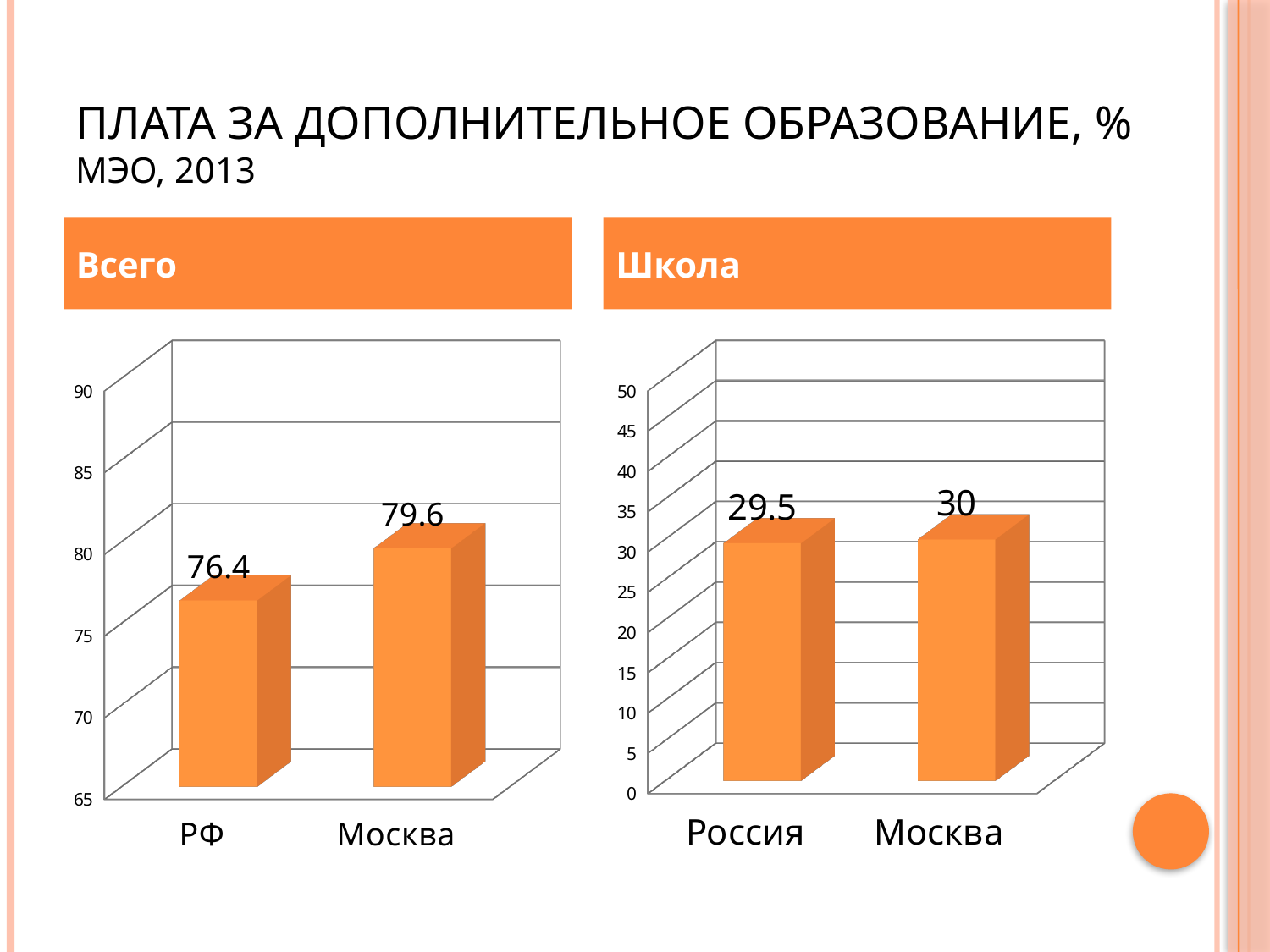
In the "Всего" chart, what is the value for РФ? 76.4 In the "Школа" chart, how many categories are shown? 2 What kind of chart is the "Всего" chart? bar chart In the "Всего" chart, what is the difference between the values for Москва and РФ? 3.2 In the "Всего" chart, which category has the highest value? Москва In the "Школа" chart, what is the value for Россия? 29.5 In the "Всего" chart, is the value for РФ greater or less than 75? greater In the "Школа" chart, what is the value for Москва? 30 In the "Школа" chart, what is the difference between the values for Москва and Россия? 0.5 In the "Всего" chart, which category has the lowest value? РФ What is the title of the chart on the right side of the slide? Школа In the "Всего" chart, what is the value for Москва? 79.6